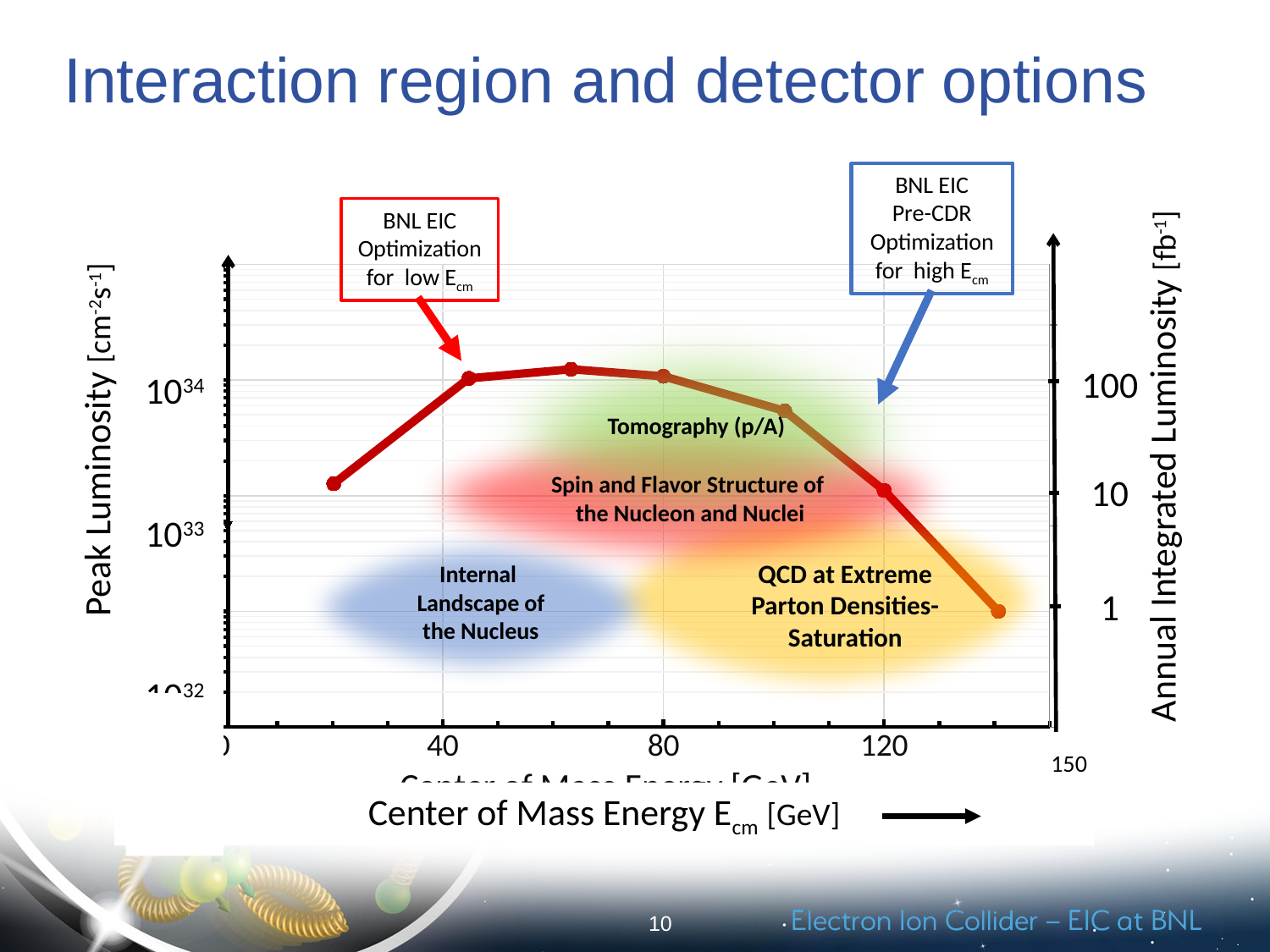
Which is larger: the peak luminosity at the lowest plotted energy (about 20 GeV) or at the highest plotted energy (about 140 GeV)? about 20 GeV What is the label of the right vertical axis? Annual Integrated Luminosity [fb^-1] Is the peak luminosity at a center of mass energy of 120 GeV greater or less than 10^34 cm^-2 s^-1? less Is the peak luminosity at a center of mass energy of 80 GeV greater or less than the peak luminosity at 120 GeV? greater How many data points are plotted on the luminosity curve? 7 Is the annual integrated luminosity at the highest plotted center of mass energy (about 140 GeV) greater or less than 10 fb^-1? less Does the peak luminosity rise or fall as the center of mass energy increases from 20 GeV to 40 GeV? rise What kind of chart is shown on the slide? line chart What is the label of the left vertical axis? Peak Luminosity [cm^-2 s^-1] Does the peak luminosity rise or fall as the center of mass energy increases from 80 GeV to 150 GeV? fall Is the peak luminosity at a center of mass energy of 80 GeV greater or less than 10^33 cm^-2 s^-1? greater